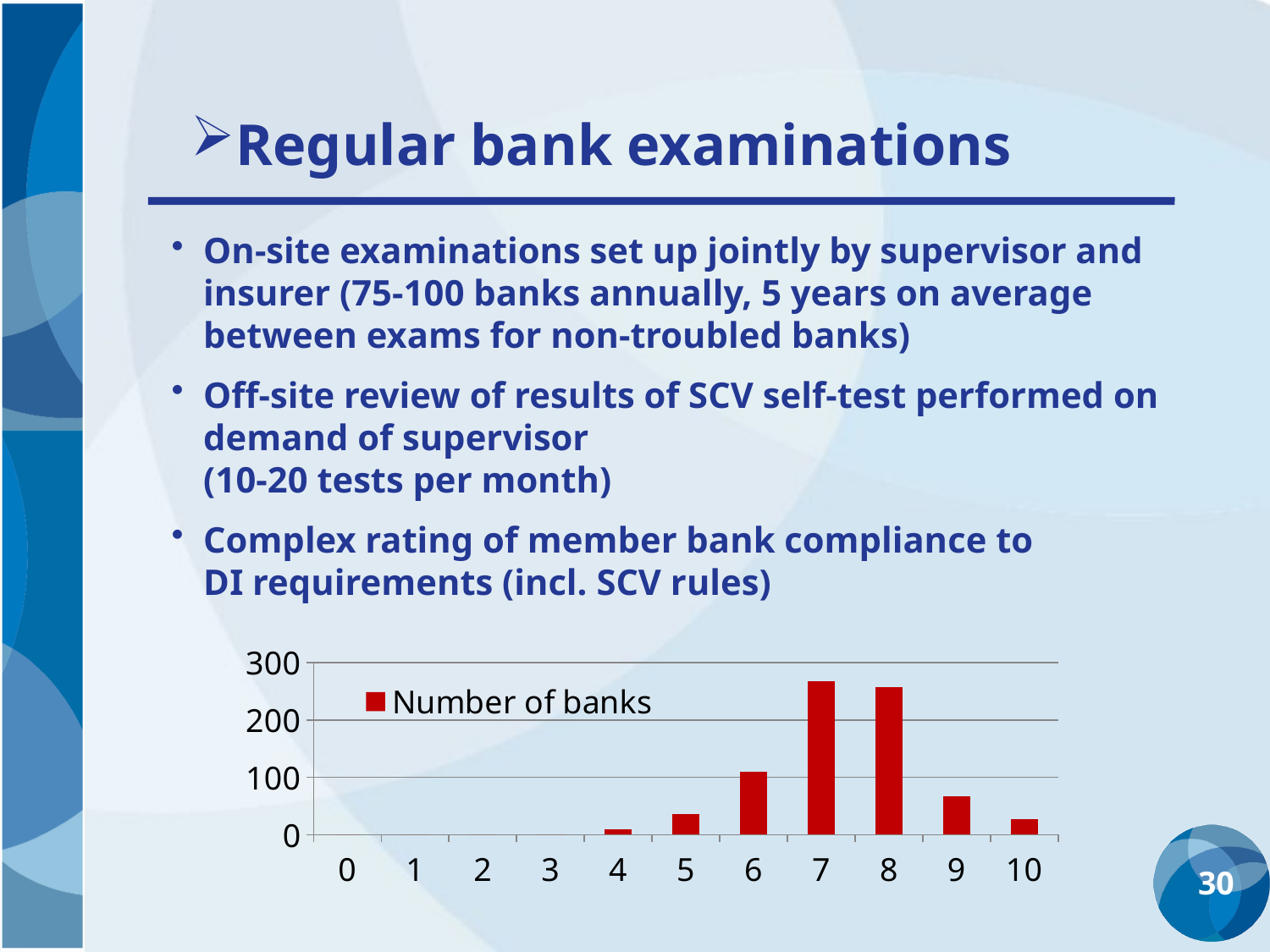
Is the value for category 8 greater or less than 200? greater How many categories are labelled on the x axis of the chart? 11 Which has a larger value, category 6 or category 9? 6 Is the value for category 7 greater or less than 200? greater Is the value for category 10 greater or less than 100? less What kind of chart is shown on the slide? bar chart Which has a larger value, category 5 or category 8? 8 How many series does the chart legend list? 1 Do the values rise or fall from category 4 to category 7? rise What is the name of the series shown in the chart legend? Number of banks